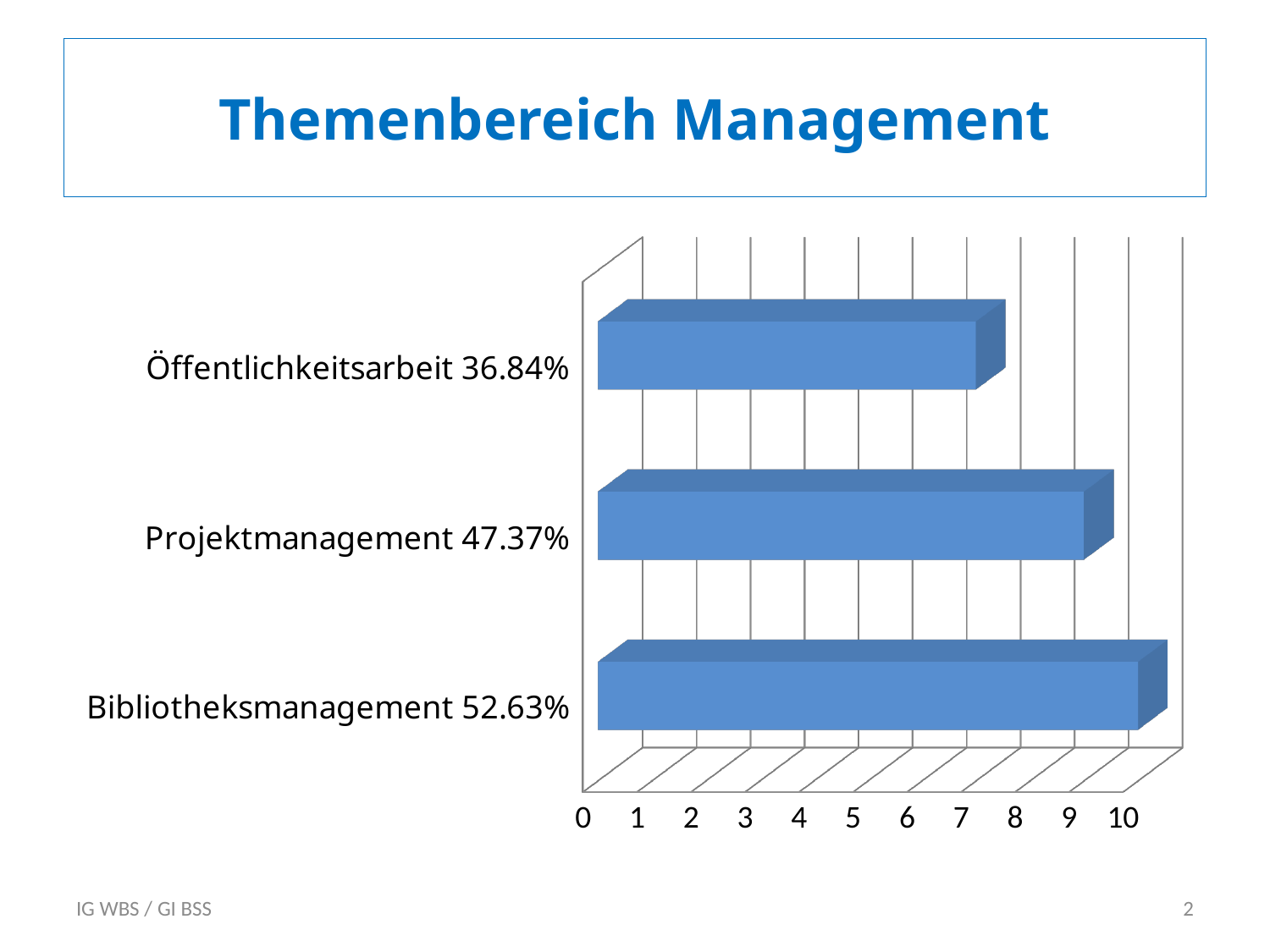
How many categories are plotted in the chart? 3 What percentage is shown in the label for Öffentlichkeitsarbeit? 36.84% Is the bar for Öffentlichkeitsarbeit greater or less than 5? greater What percentage is shown in the label for Projektmanagement? 47.37% What is the title of the slide containing the chart? Themenbereich Management Which category has the shortest bar? Öffentlichkeitsarbeit Which category has the longest bar? Bibliotheksmanagement Is the bar for Projektmanagement greater or less than 8? greater Is the bar for Öffentlichkeitsarbeit greater or less than 8? less Which bar is longer, Projektmanagement or Öffentlichkeitsarbeit? Projektmanagement What percentage is shown in the label for Bibliotheksmanagement? 52.63% What kind of chart is shown on the slide? bar chart